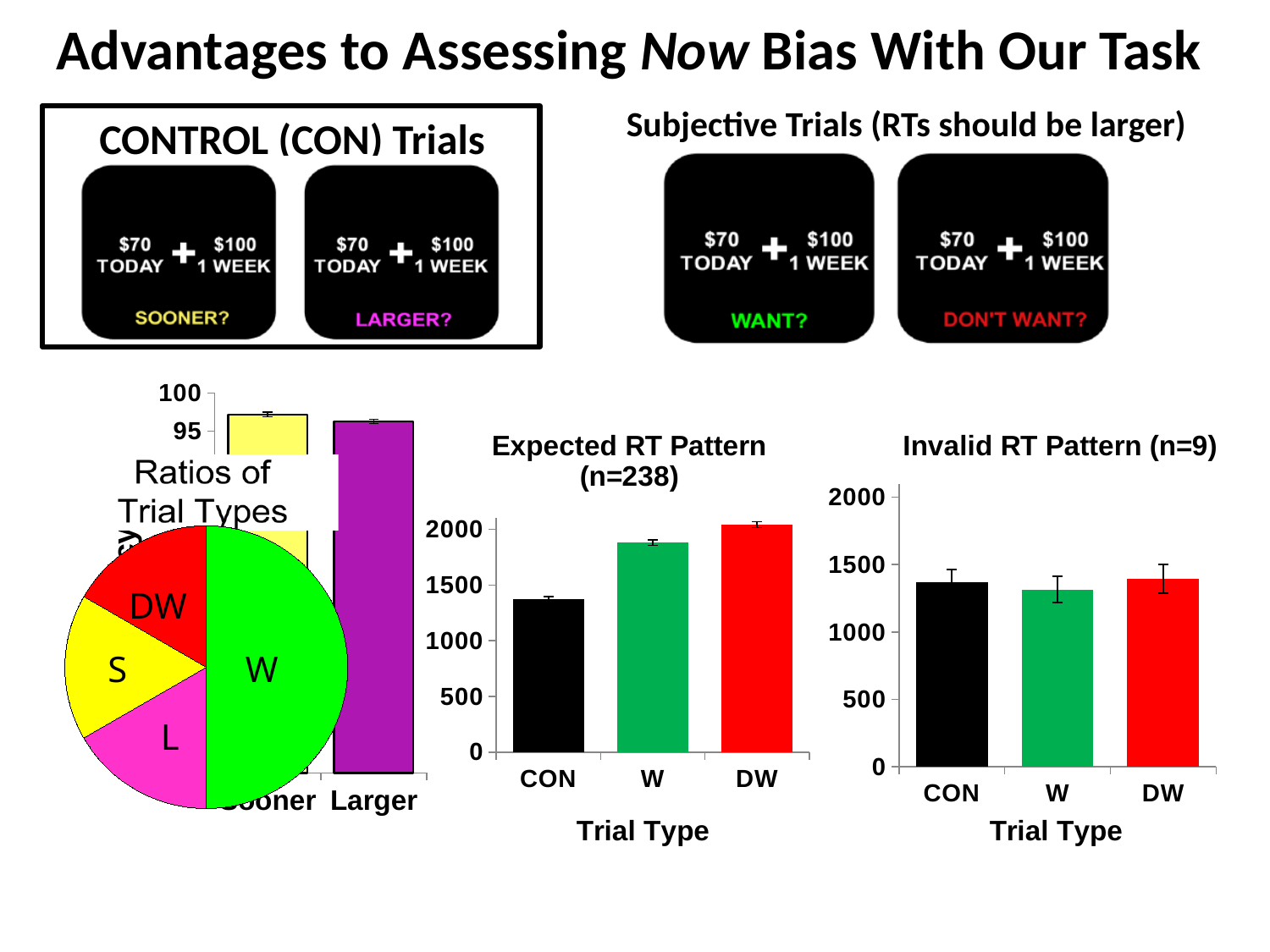
In the Ratios of Trial Types pie chart, which slice is the largest? W In the Expected RT Pattern (n=238) chart, which trial type has the lowest value? CON What kind of chart is the Invalid RT Pattern (n=9) chart? bar chart In the Expected RT Pattern (n=238) chart, which is larger, the value for W or the value for CON? W In the Expected RT Pattern (n=238) chart, is the value for W greater or less than 1500? greater In the Expected RT Pattern (n=238) chart, do the values rise or fall from CON to DW along the x axis? rise In the Invalid RT Pattern (n=9) chart, is the value for W greater or less than 1000? greater In the Expected RT Pattern (n=238) chart, is the value for CON greater or less than 1500? less In the Expected RT Pattern (n=238) chart, which trial type has the highest value? DW How many slices does the Ratios of Trial Types pie chart have? 4 How many trial types are shown on the x axis of the Invalid RT Pattern (n=9) chart? 3